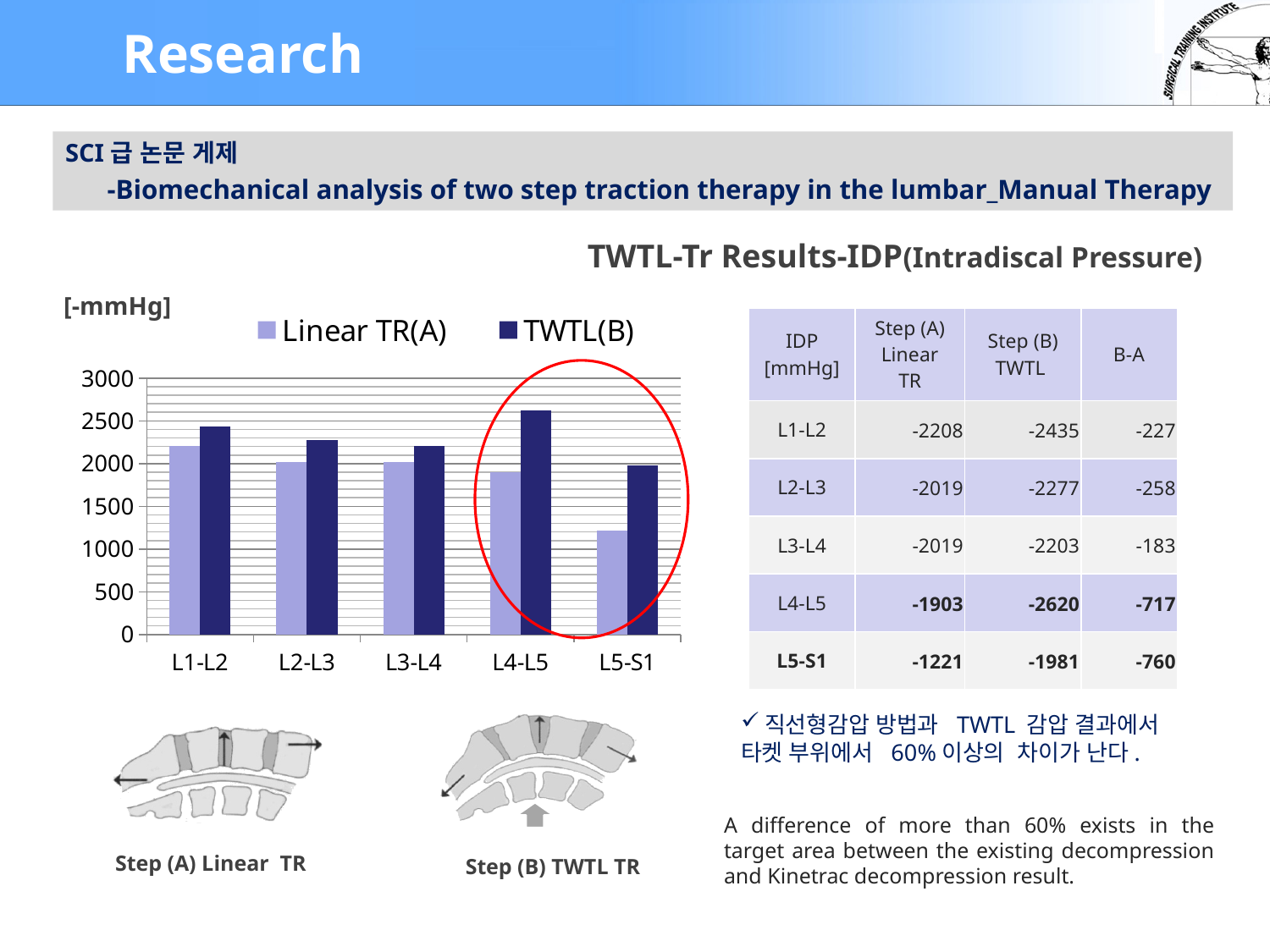
Is the Linear TR(A) value for L5-S1 greater or less than 1500? less Which category has the highest TWTL(B) bar? L4-L5 Which category has the lowest Linear TR(A) bar? L5-S1 Is the Linear TR(A) value for L1-L2 greater or less than 2000? greater What are the two entries in the chart legend? Linear TR(A) and TWTL(B) Which category has the lowest TWTL(B) bar? L5-S1 How many series does the chart legend list? 2 Is the TWTL(B) value for L4-L5 greater or less than 2500? greater At L4-L5, which series has the larger bar, Linear TR(A) or TWTL(B)? TWTL(B) How many categories are shown on the x axis of the chart? 5 Do the Linear TR(A) bars generally rise or fall from L1-L2 to L5-S1? fall What kind of chart is shown on the slide? Bar chart